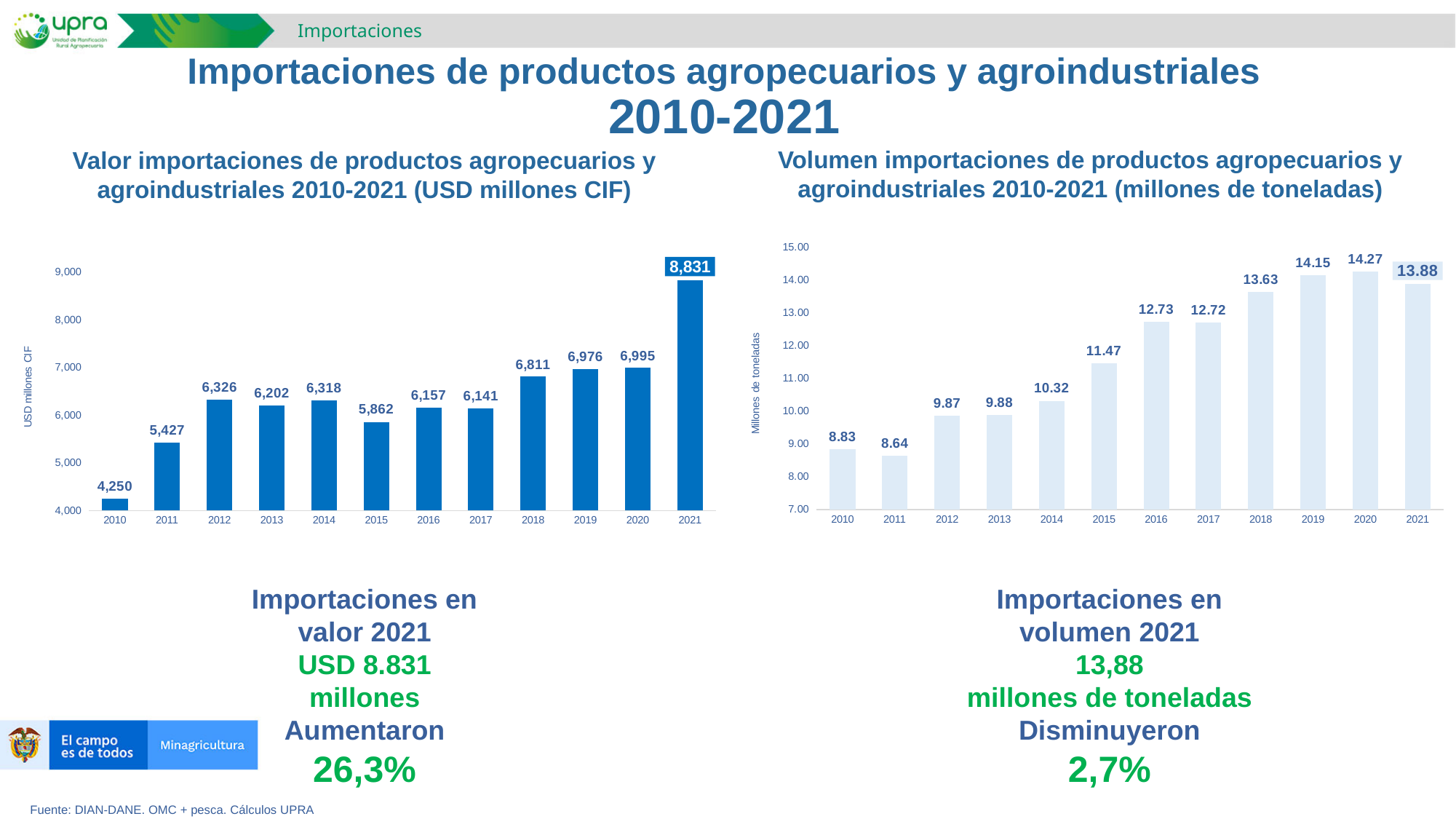
In the left chart (Valor importaciones, USD millones CIF), how many years are plotted? 12 In the right chart (Volumen importaciones, millones de toneladas), which year has the lowest value? 2011 In the left chart (Valor importaciones, USD millones CIF), which year has the highest value? 2021 What is the y-axis label of the left chart (Valor importaciones)? USD millones CIF In the right chart (Volumen importaciones, millones de toneladas), what is the value for 2015? 11.47 What type of chart is the right chart (Volumen importaciones, millones de toneladas)? Bar chart In the right chart (Volumen importaciones, millones de toneladas), which year has the highest value? 2020 In the left chart (Valor importaciones, USD millones CIF), which year has the lowest value? 2010 In the left chart (Valor importaciones, USD millones CIF), what is the value for 2010? 4,250 In the right chart (Volumen importaciones, millones de toneladas), what is the difference between the values for 2020 and 2021? 0.39 In the left chart (Valor importaciones, USD millones CIF), what is the difference between the values for 2021 and 2020? 1,836 In the left chart (Valor importaciones, USD millones CIF), which year has the larger value, 2012 or 2015? 2012